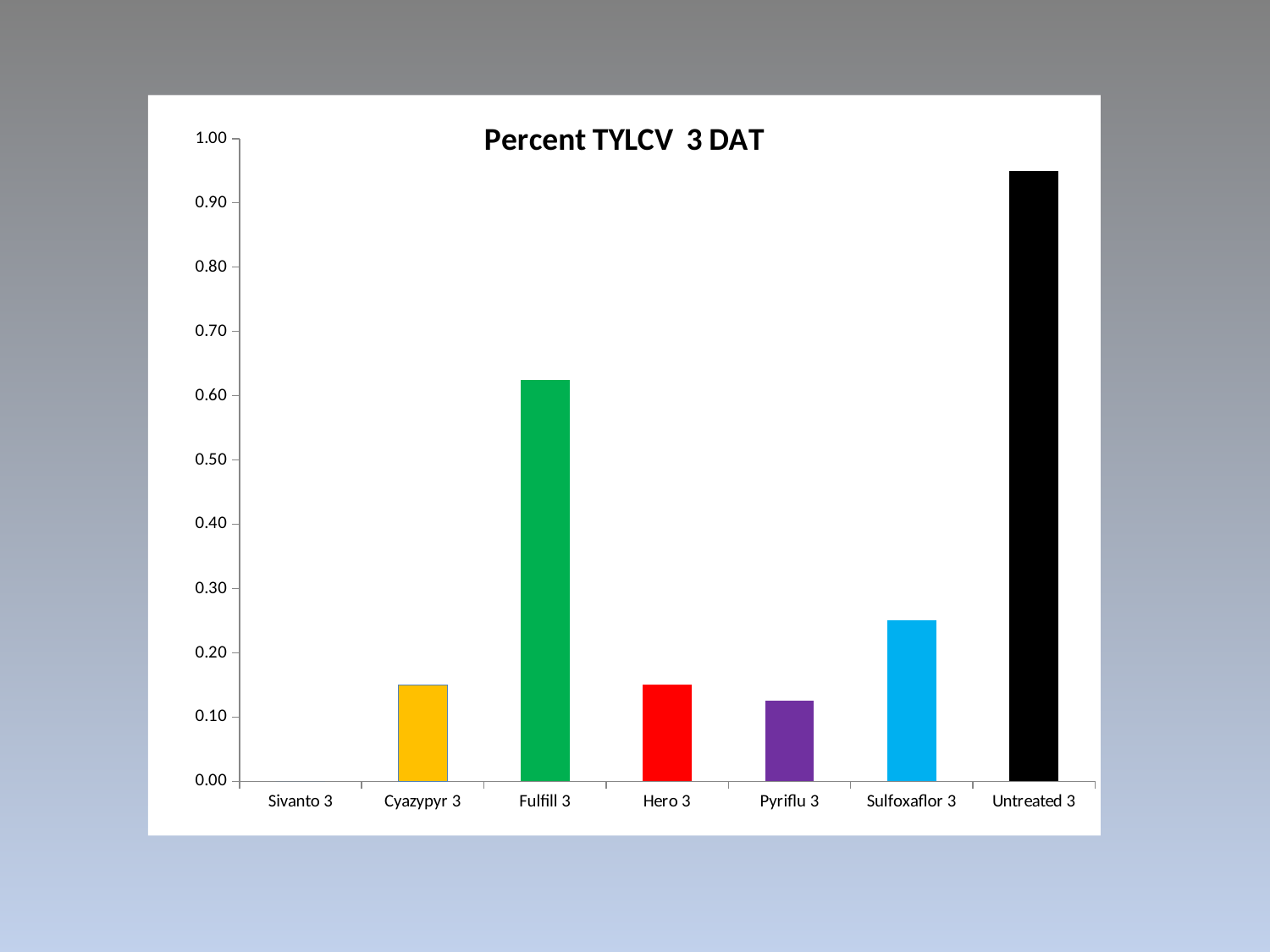
Is the value for Untreated 3 greater or less than 0.90? greater What is the title of the chart? Percent TYLCV 3 DAT Is the value for Cyazypyr 3 greater or less than 0.20? less How many categories are shown on the x axis? 7 Is the value for Fulfill 3 greater or less than 0.70? less Which is larger, the value for Fulfill 3 or the value for Sulfoxaflor 3? Fulfill 3 What kind of chart is shown on the slide? bar chart Which category has the highest value? Untreated 3 Which category has the lowest value? Sivanto 3 Which is larger, the value for Sulfoxaflor 3 or the value for Pyriflu 3? Sulfoxaflor 3